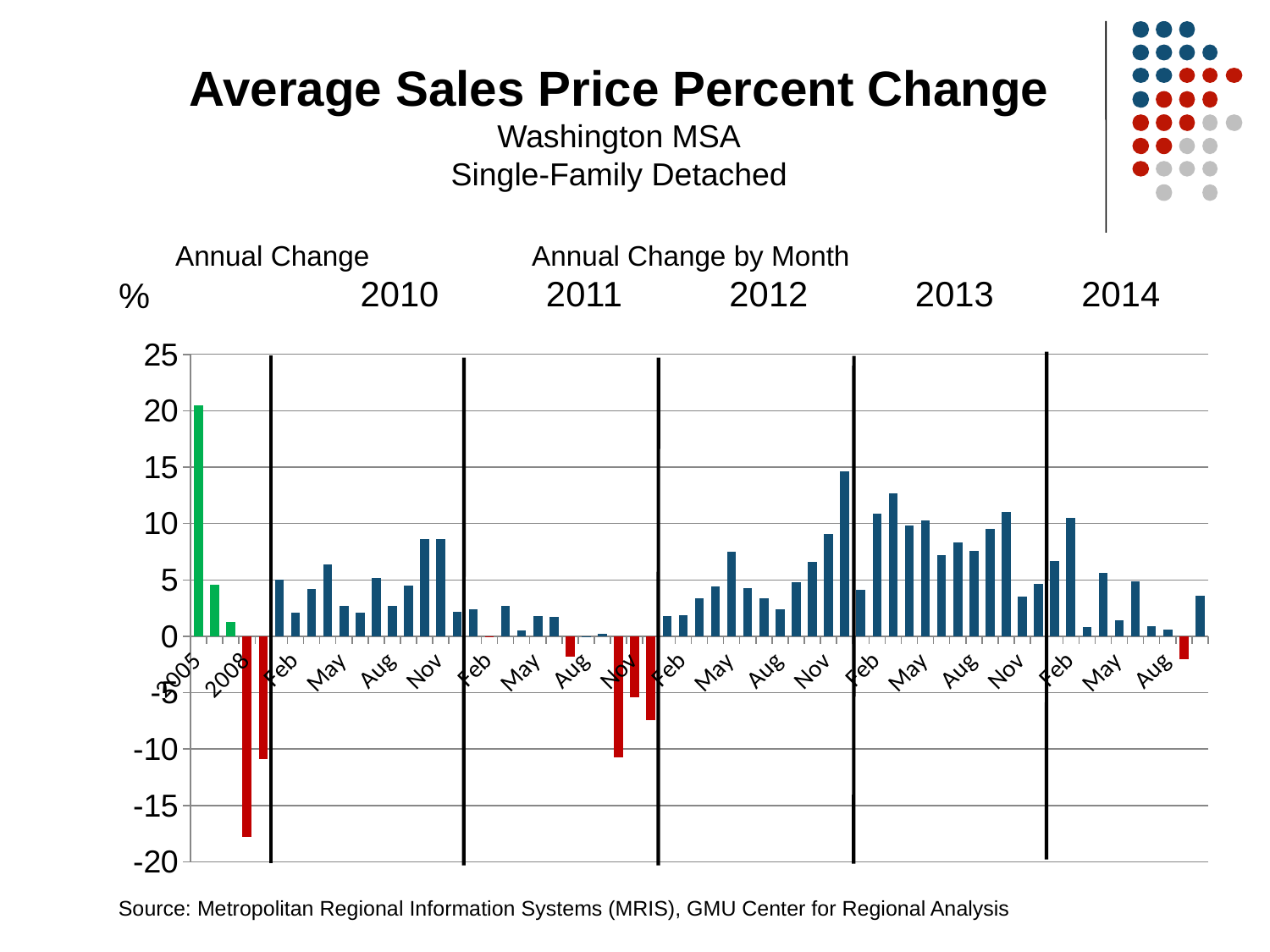
Is the annual change value for 2005 greater or less than 15? greater Which bar on the chart is the lowest? 2008 (Annual Change) Is the annual change value for 2008 greater or less than -15? less Which is larger, the value for Nov 2012 or the value for Feb 2013? Feb 2013 Is the value for Nov 2012 greater or less than 10? less What is the title of the chart on the slide? Average Sales Price Percent Change How many years are labeled in the 'Annual Change by Month' section of the chart? 5 What kind of chart is shown on the slide? bar chart Do the monthly values generally rise or fall from Jan 2012 to Nov 2012? rise Which bar on the chart is the highest? 2005 (Annual Change)